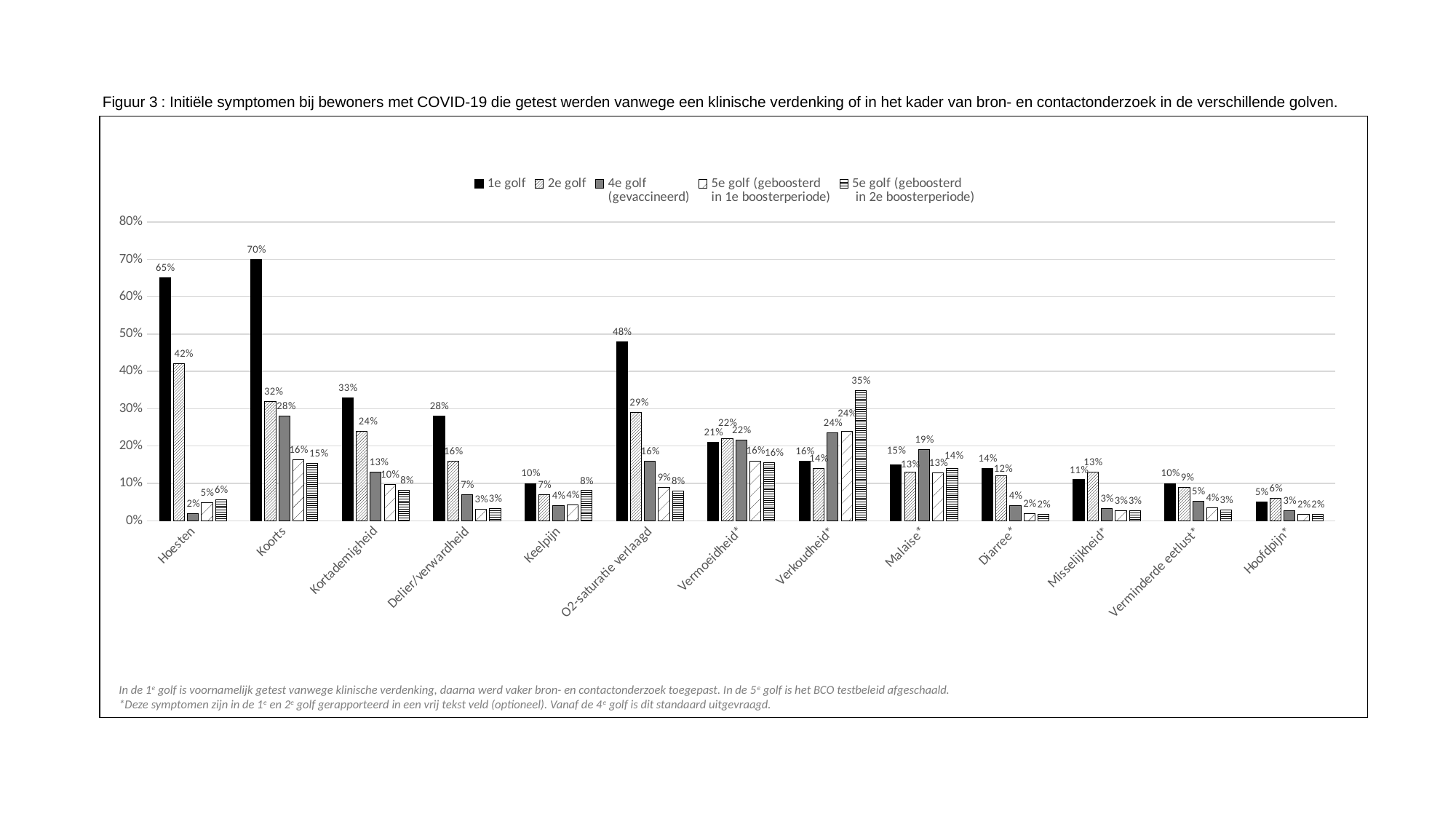
Which symptom has the lowest value in the 4e golf (gevaccineerd) series? Hoesten What is the value for Malaise* in the 4e golf (gevaccineerd) series? 19% How many symptom categories are shown on the x axis? 13 What is the value for Hoesten in the 2e golf series? 42% Which symptom has the highest value in the 1e golf series? Koorts What is the value for Verkoudheid* in the 5e golf (geboosterd in 2e boosterperiode) series? 35% How many series does the legend list? 5 Do the 1e golf values generally rise or fall from Hoesten to Hoofdpijn* along the x axis? Fall For O2-saturatie verlaagd, which is larger: the 1e golf value or the 2e golf value? 1e golf What is the value for Koorts in the 1e golf series? 70% What is the difference between the 1e golf and 2e golf values for Hoesten? 23% What kind of chart is shown on the slide? Bar chart